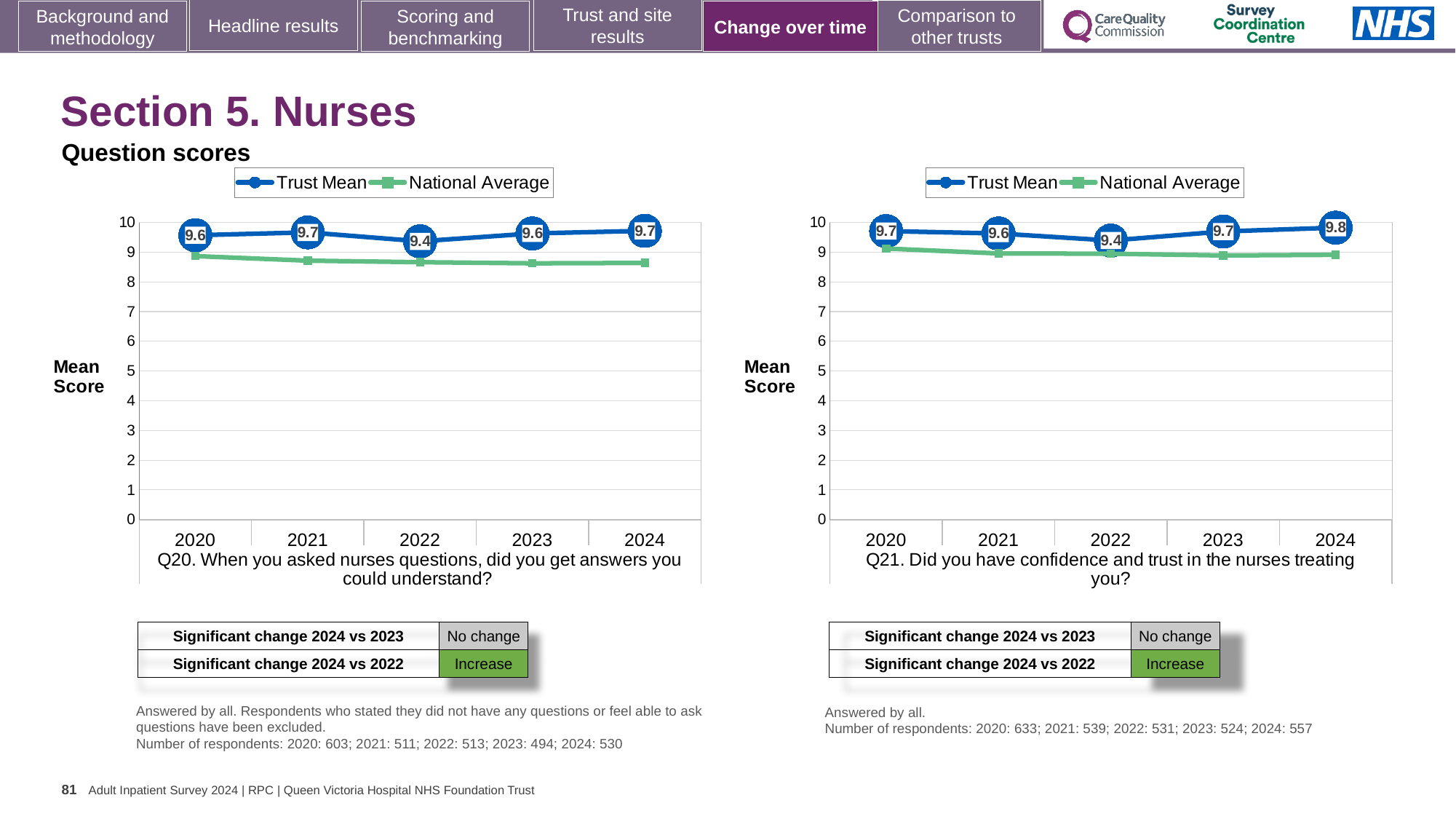
In the Q21 chart (right), what is the difference between the Trust Mean scores for 2024 and 2022? 0.4 In the Q21 chart (right), does the Trust Mean score rise or fall from 2022 to 2024? Rise In the Q20 chart (left), which year has the lowest Trust Mean score? 2022 How many series does the legend of the Q21 chart (right) list? 2 What type of chart is used for the Q20 chart (left)? Line chart In the Q20 chart (left), is the National Average value for 2024 greater or less than 9? less In the Q20 chart (left), is the Trust Mean score higher in 2021 or in 2022? 2021 In the Q20 chart (left), what is the Trust Mean score for 2024? 9.7 In the Q21 chart (right), which year has the highest Trust Mean score? 2024 How many years are shown on the x axis of the Q20 chart (left)? 5 In the Q21 chart (right), what is the Trust Mean score for 2022? 9.4